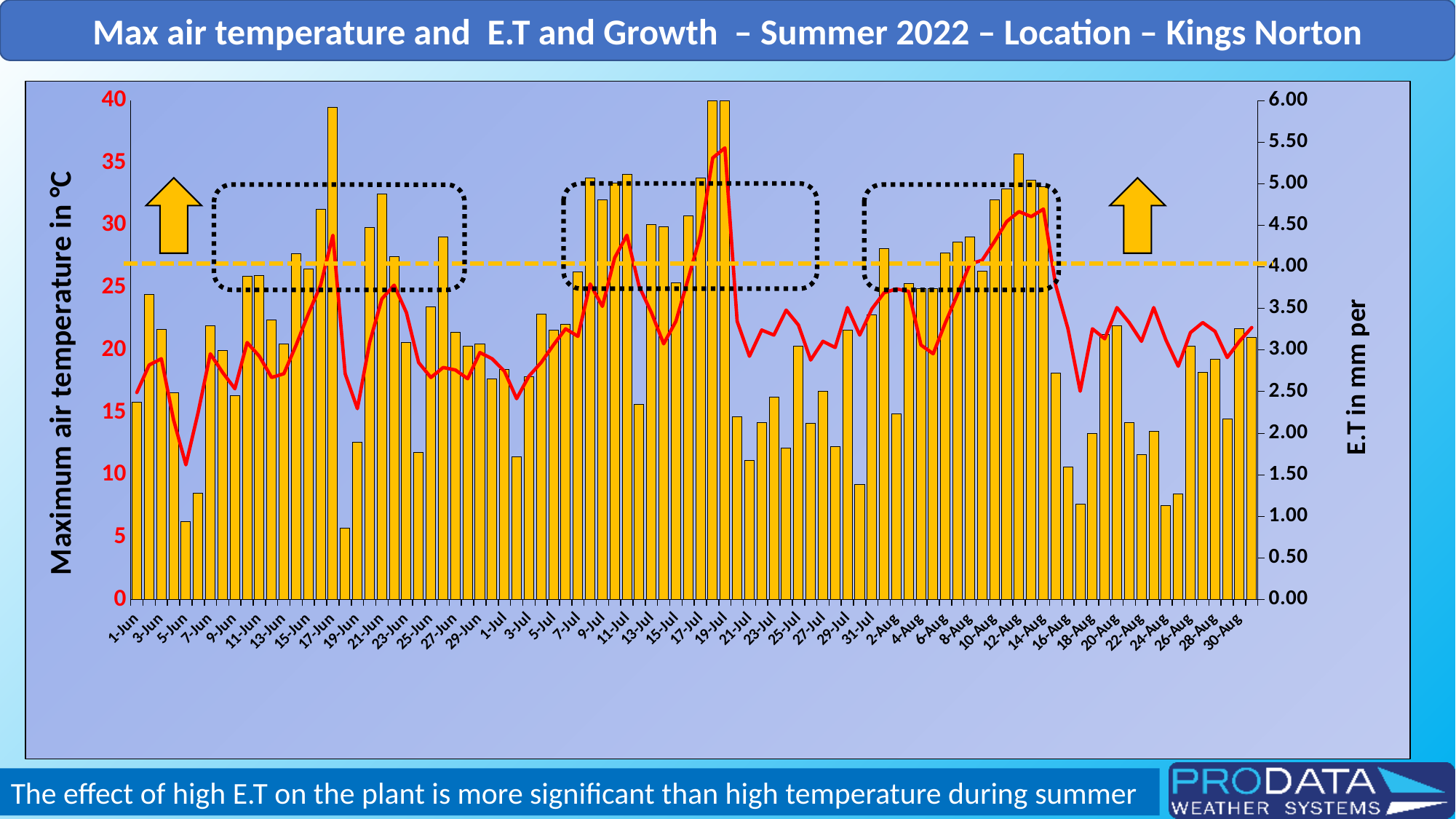
Is the E.T bar for 17-Jun greater or less than 5.50 on the right axis? greater Is the maximum air temperature (red line) on 5-Jun greater or less than 15 °C? less What kind of chart is shown on the slide? Combined bar and line chart Is the maximum air temperature (red line) on 19-Jul greater or less than 30 °C? greater In which month does the red maximum air temperature line reach its highest point? July What is the title of the left vertical axis? Maximum air temperature in °C What is the title of the right vertical axis? E.T in mm per Does the red maximum air temperature line rise or fall from 3-Jun to 5-Jun? fall Which date has the higher maximum air temperature on the red line, 19-Jul or 5-Jun? 19-Jul Which has the taller E.T bar, 17-Jun or 18-Jun? 17-Jun